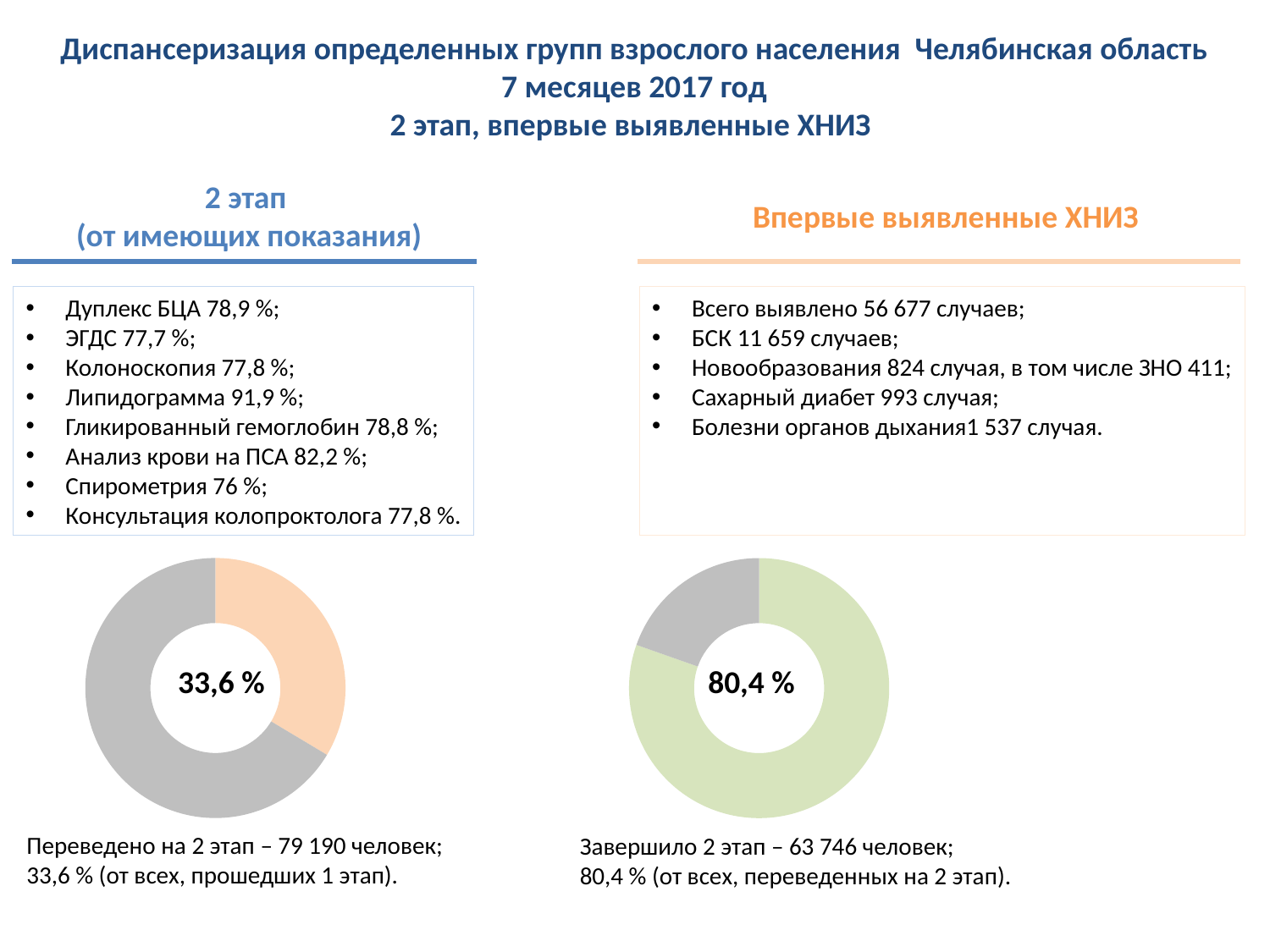
In the left doughnut chart, which slice is larger, the orange one or the grey one? the grey one What value is printed in the centre of the left doughnut chart? 33,6 % How many slices does the right doughnut chart have? 2 In the right doughnut chart, what share does the green slice represent? 80,4 % How many slices does the left doughnut chart have? 2 In the right doughnut chart, which slice is larger, the green one or the grey one? the green one What value is printed in the centre of the right doughnut chart? 80,4 % What kind of chart is shown on the left side of the slide? doughnut chart What colour is the highlighted slice in the right doughnut chart? green What kind of chart is shown on the right side of the slide? doughnut chart Which doughnut chart shows the higher percentage in its centre, the left one or the right one? the right one In the left doughnut chart, what share does the orange slice represent? 33,6 %